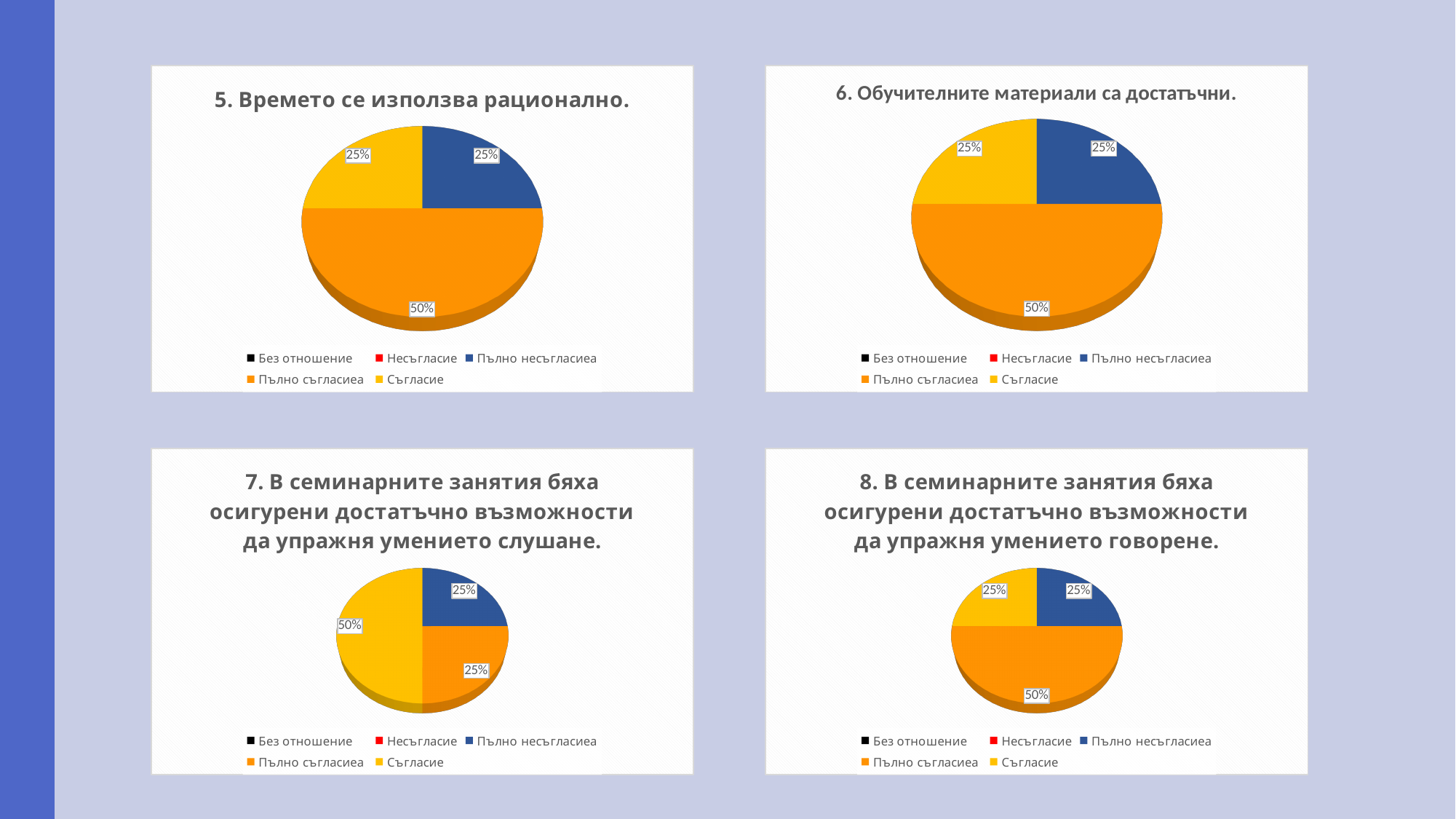
In the chart titled "5. Времето се използва рационално.", what share is labelled for Пълно съгласиеа? 50% In the bottom-right chart (question 8, about the skill говорене), what share is labelled for Пълно съгласиеа? 50% In the bottom-left chart (question 7, about the skill слушане), which category has the largest slice? Съгласие In the bottom-right chart (question 8, about the skill говорене), what share is labelled for Пълно несъгласиеа? 25% In the bottom-left chart (question 7, about the skill слушане), what share is labelled for Пълно съгласиеа? 25% What kind of chart is used in the chart titled "5. Времето се използва рационално."? Pie chart How many slices with labels are shown in the bottom-right chart (question 8, about the skill говорене)? 3 In the chart titled "6. Обучителните материали са достатъчни.", what is the difference between the Пълно съгласиеа slice and the Пълно несъгласиеа slice? 25% In the chart titled "5. Времето се използва рационално.", which category has the largest slice? Пълно съгласиеа In the chart titled "6. Обучителните материали са достатъчни.", what share is labelled for Съгласие? 25% How many entries does the legend list in the chart titled "6. Обучителните материали са достатъчни."? 5 In the bottom-left chart (question 7, about the skill слушане), which is larger: the Съгласие slice or the Пълно несъгласиеа slice? Съгласие